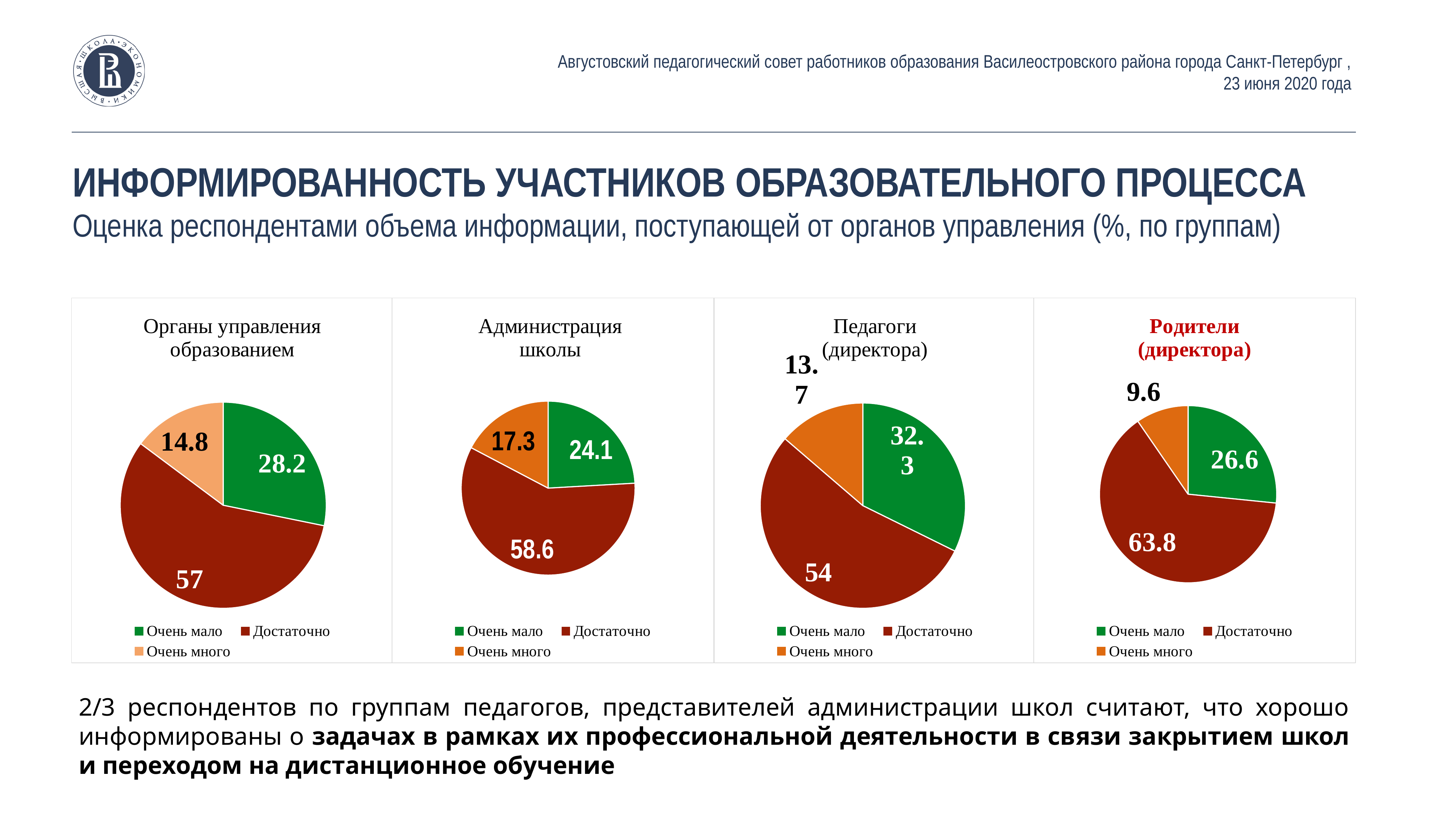
In the pie chart titled "Педагоги (директора)", which is larger: the value for "Очень мало" or the value for "Очень много"? Очень мало In the pie chart titled "Педагоги (директора)", what is the value for "Очень мало"? 32.3 In the pie chart titled "Родители (директора)", what is the value for "Очень много"? 9.6 How many slices does the pie chart titled "Органы управления образованием" have? 3 How many pie charts are shown on the slide? 4 In the pie chart titled "Органы управления образованием", which category has the smallest slice? Очень много In the pie chart titled "Органы управления образованием", what is the value for "Достаточно"? 57 In the pie chart titled "Администрация школы", what is the value for "Очень много"? 17.3 How many entries does the legend of the pie chart titled "Родители (директора)" list? 3 In the pie chart titled "Родители (директора)", which category has the largest slice? Достаточно In the pie chart titled "Администрация школы", what is the difference between the values for "Достаточно" and "Очень мало"? 34.5 What type of chart is used for "Администрация школы"? Pie chart